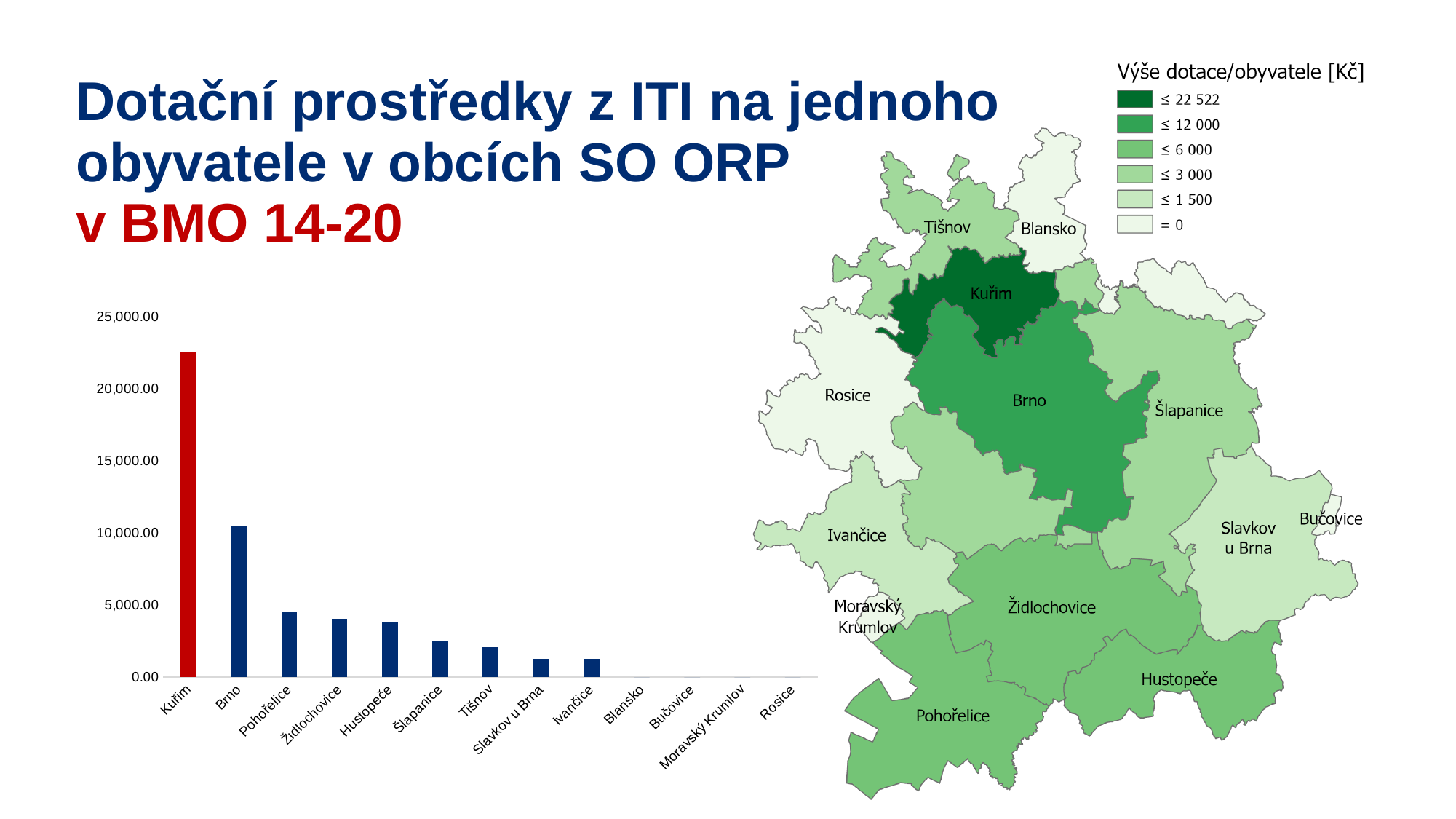
Is the value for Tišnov greater or less than 5,000? less What kind of chart is shown on the left of the slide? bar chart Is the value for Kuřim greater or less than 20,000? greater Do the values in the bar chart rise or fall from left to right along the x axis? fall Which category has the highest value in the bar chart? Kuřim Which has a larger value, Brno or Pohořelice? Brno Is the value for Pohořelice greater or less than 5,000? less How many categories are shown on the x axis of the bar chart? 13 Which has a larger value, Kuřim or Brno? Kuřim Which has a larger value, Šlapanice or Tišnov? Šlapanice Which bar in the bar chart is coloured red rather than blue? Kuřim